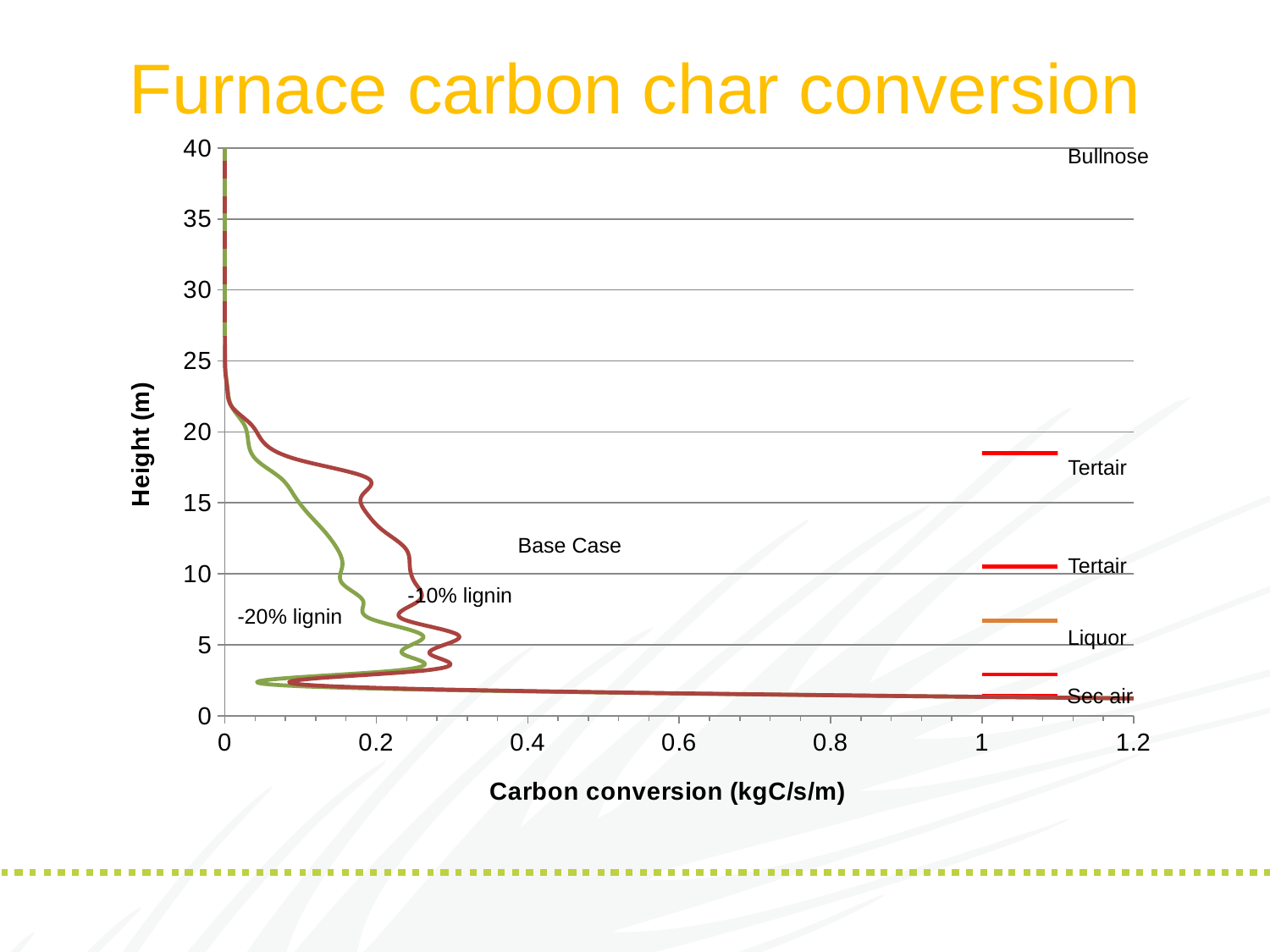
Is the carbon conversion of the -10% lignin curve at a height of 20 m greater or less than 0.2? less What is the title of the chart on the slide? Furnace carbon char conversion What is the maximum height shown on the vertical axis? 40 Is the carbon conversion of either curve at a height of 30 m greater or less than 0.2? less What is the label of the vertical axis? Height (m) At a height of 15 m, which curve has the higher carbon conversion, -10% lignin or -20% lignin? -10% lignin Above a height of about 5 m, does carbon conversion generally rise or fall as height increases? fall Is the carbon conversion of the -10% lignin curve at a height of 5 m greater or less than 0.2? greater What kind of chart is shown on the slide? line chart